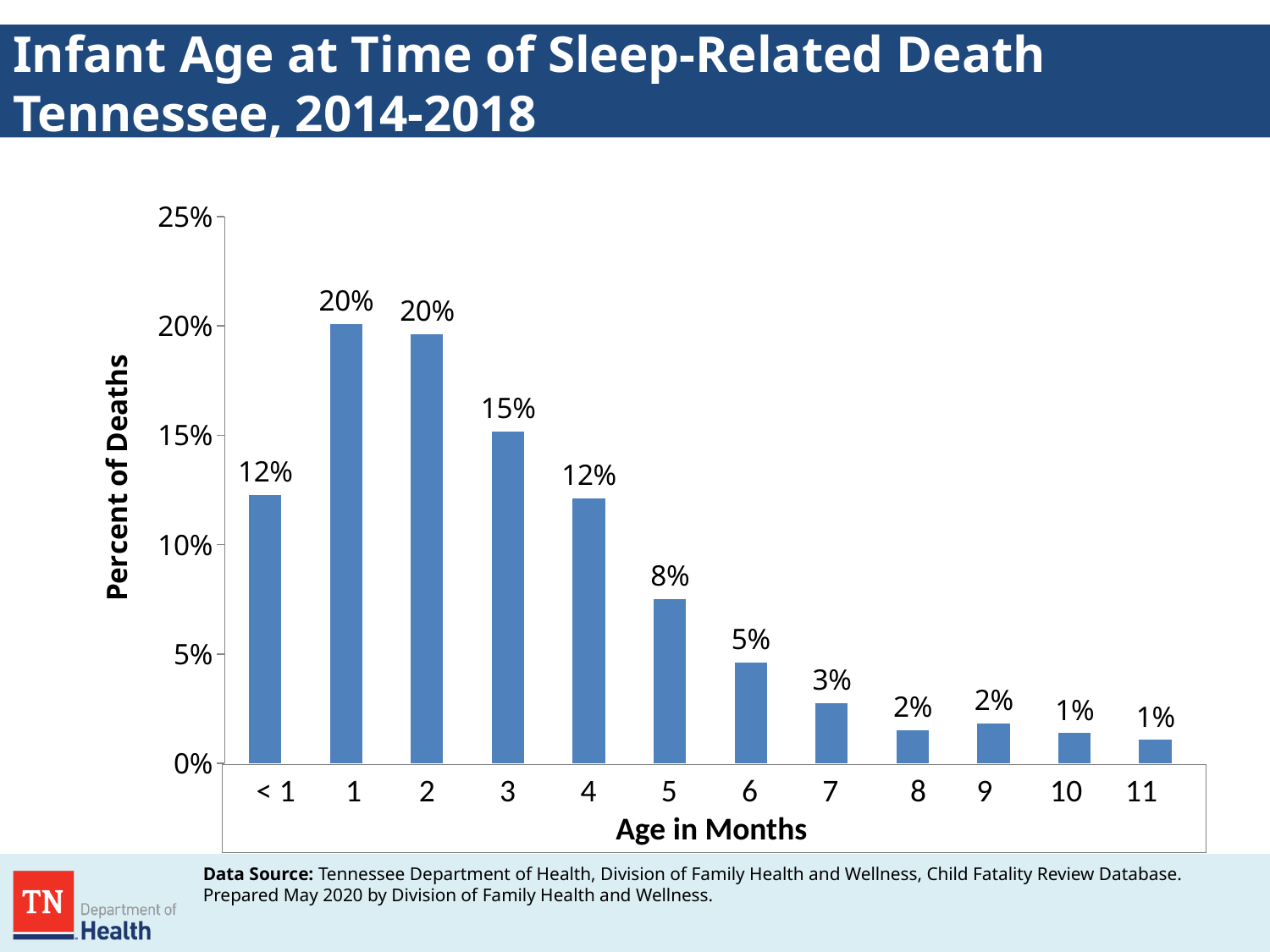
What is the difference between the values for age 3 months and age 5 months? 7% Which has a larger value, age 3 months or age 4 months? 3 months From age 1 month onward, do the values rise or fall as age increases? fall What is the title of the y axis? Percent of Deaths Is the value for age 3 months greater or less than 10%? greater How many age categories are shown on the x axis? 12 What is the value shown for age 7 months? 3% What is the value for infants under 1 month (< 1)? 12% What is the difference between the values for age 1 month and age 4 months? 8% What percent of deaths occurred at age 5 months? 8% What kind of chart is shown on the slide? bar chart What percent of deaths occurred at age 3 months? 15%